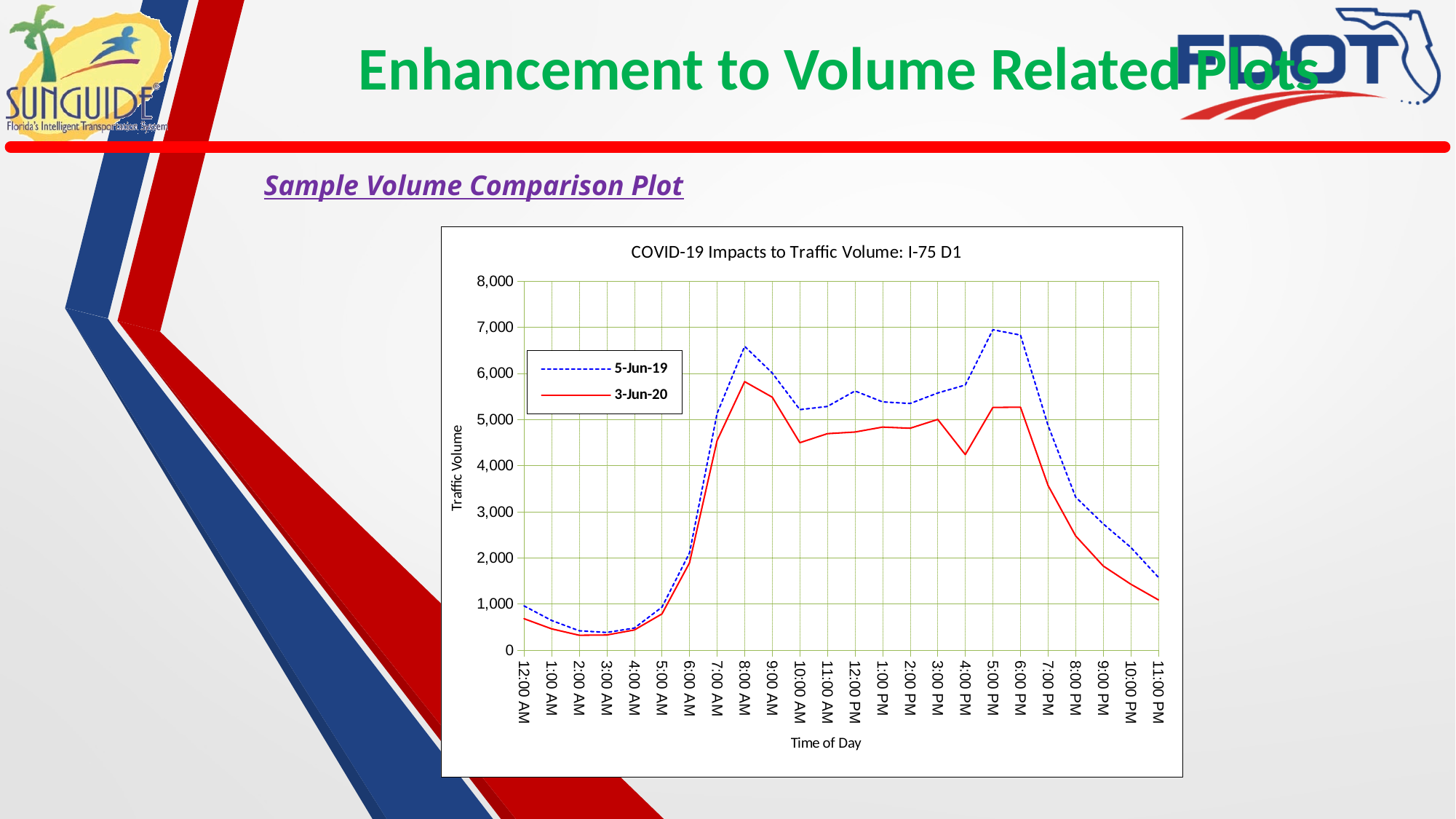
Is the value for 3-Jun-20 at 10:00 AM greater or less than 5,000? less What is the title of the chart? COVID-19 Impacts to Traffic Volume: I-75 D1 Is the value for 5-Jun-19 at 8:00 AM greater or less than 6,000? greater At 5:00 PM, which series has the higher traffic volume, 5-Jun-19 or 3-Jun-20? 5-Jun-19 What is the label of the vertical axis? Traffic Volume Does the 3-Jun-20 series rise or fall from 8:00 PM to 11:00 PM? Fall Is the value for 3-Jun-20 at 4:00 PM greater or less than 5,000? less At what time of day does the 3-Jun-20 series reach its highest traffic volume? 8:00 AM How many time-of-day points are plotted along the x axis? 24 What kind of chart is shown on the slide? Line chart How many series does the legend list? 2